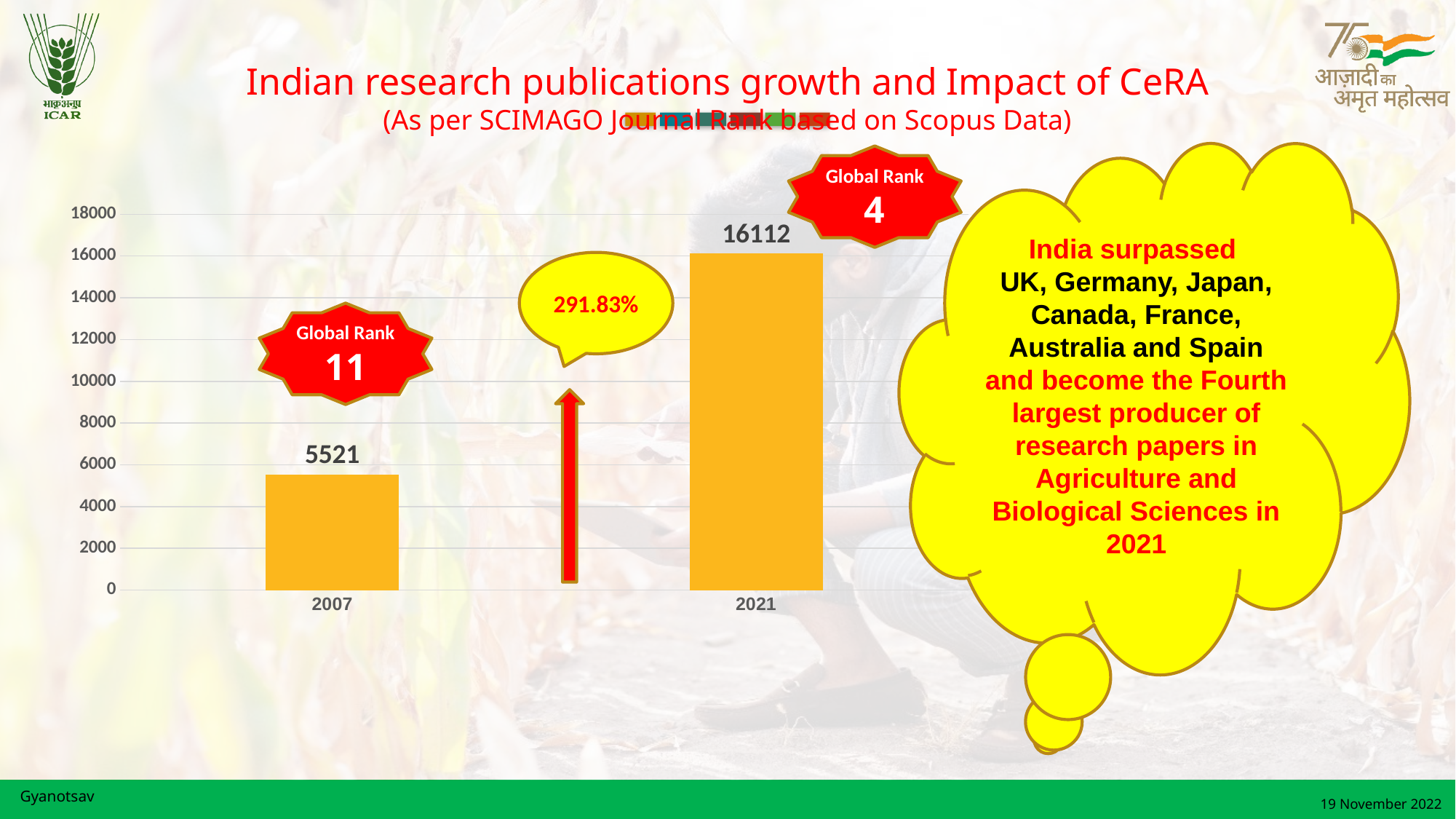
How many years are shown on the x axis? 2 Do the values rise or fall from 2007 to 2021? Rise Which year has the higher value? 2021 What is the value for 2007? 5521 What is the difference between the values for 2021 and 2007? 10591 What is the value for 2021? 16112 What percentage growth is shown in the callout between the two bars? 291.83% Is the value for 2007 greater or less than 6000? less What kind of chart is shown on the slide? Bar chart Is the value for 2021 greater or less than 16000? greater Is the value for 2021 larger than the value for 2007? Yes Which year has the lower value? 2007